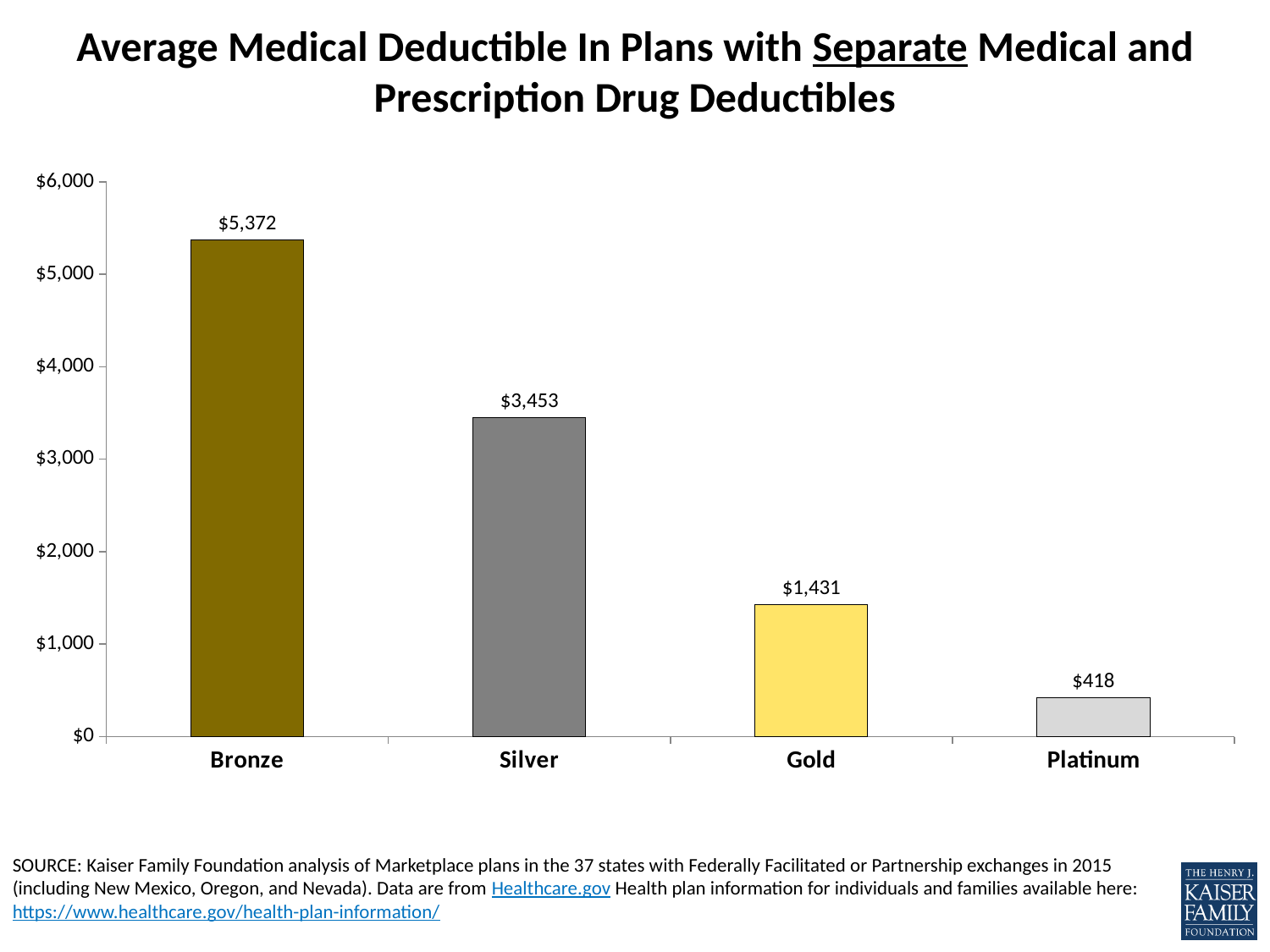
What is the average medical deductible for Gold plans? $1,431 How many plan tiers are shown on the chart? 4 Which plan tier has the highest average medical deductible? Bronze What is the difference between the Bronze and Silver average medical deductibles? $1,919 Which plan tier has the lowest average medical deductible? Platinum What is the average medical deductible for Platinum plans? $418 What kind of chart is shown on the slide? Bar chart Is the value for Silver greater or less than $3,000? greater What is the average medical deductible for Bronze plans? $5,372 Which has a larger average medical deductible, Silver or Gold? Silver What is the difference between the Gold and Platinum average medical deductibles? $1,013 What is the average medical deductible for Silver plans? $3,453